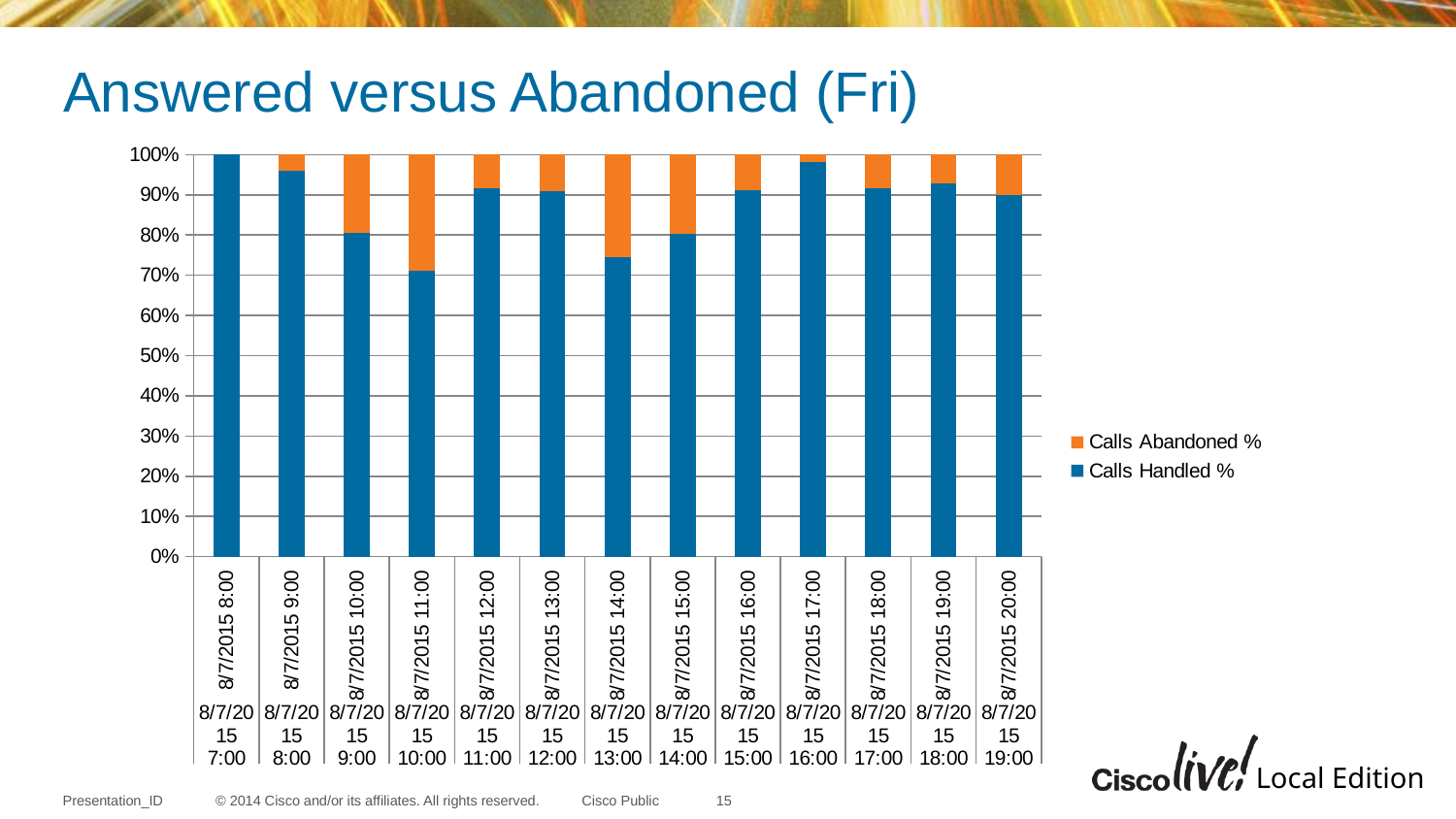
Is the Calls Handled % for 8/7/2015 17:00 greater or less than 90%? greater Which has a larger Calls Handled %, 8/7/2015 14:00 or 8/7/2015 16:00? 8/7/2015 16:00 What kind of chart is shown on the slide? Stacked bar chart What is the total of the stacked bar for 8/7/2015 12:00? 100% At which time slot is Calls Handled % the lowest? 8/7/2015 11:00 How many series does the legend list? 2 How many time-slot bars are plotted in the chart? 13 At which time slot is Calls Handled % the highest? 8/7/2015 8:00 What is the title of the chart? Answered versus Abandoned (Fri) Which series is shown in orange? Calls Abandoned % Is the Calls Handled % for 8/7/2015 11:00 greater or less than 80%? less What is the Calls Handled % value for 8/7/2015 8:00? 100%